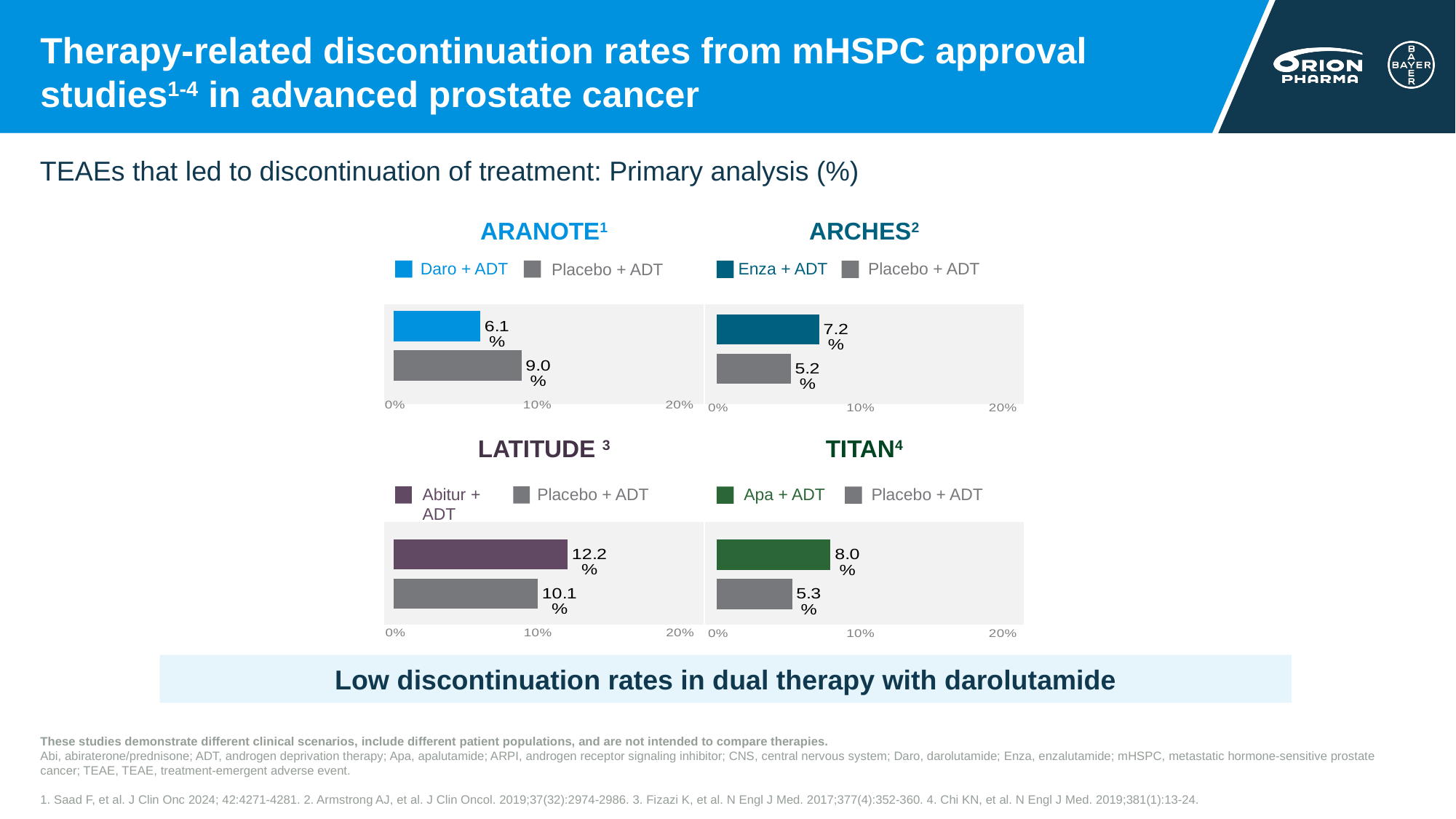
In the ARANOTE chart, what is the discontinuation rate for Placebo + ADT? 9.0% In the TITAN chart, what is the value for Placebo + ADT? 5.3% In the ARANOTE chart, what is the discontinuation rate for Daro + ADT? 6.1% In the ARANOTE chart, what is the difference between the Placebo + ADT and Daro + ADT values? 2.9% How many series does the legend of the TITAN chart list? 2 In the LATITUDE chart, what is the value for Abitur + ADT? 12.2% In the TITAN chart, what is the difference between Apa + ADT and Placebo + ADT? 2.7% What kind of chart is the ARANOTE chart? Bar chart What is the title of the chart in the top-right position? ARCHES In the LATITUDE chart, is the value for Abitur + ADT greater or less than 10%? greater In the ARCHES chart, what is the value for Enza + ADT? 7.2% In the ARCHES chart, which is larger, Enza + ADT or Placebo + ADT? Enza + ADT